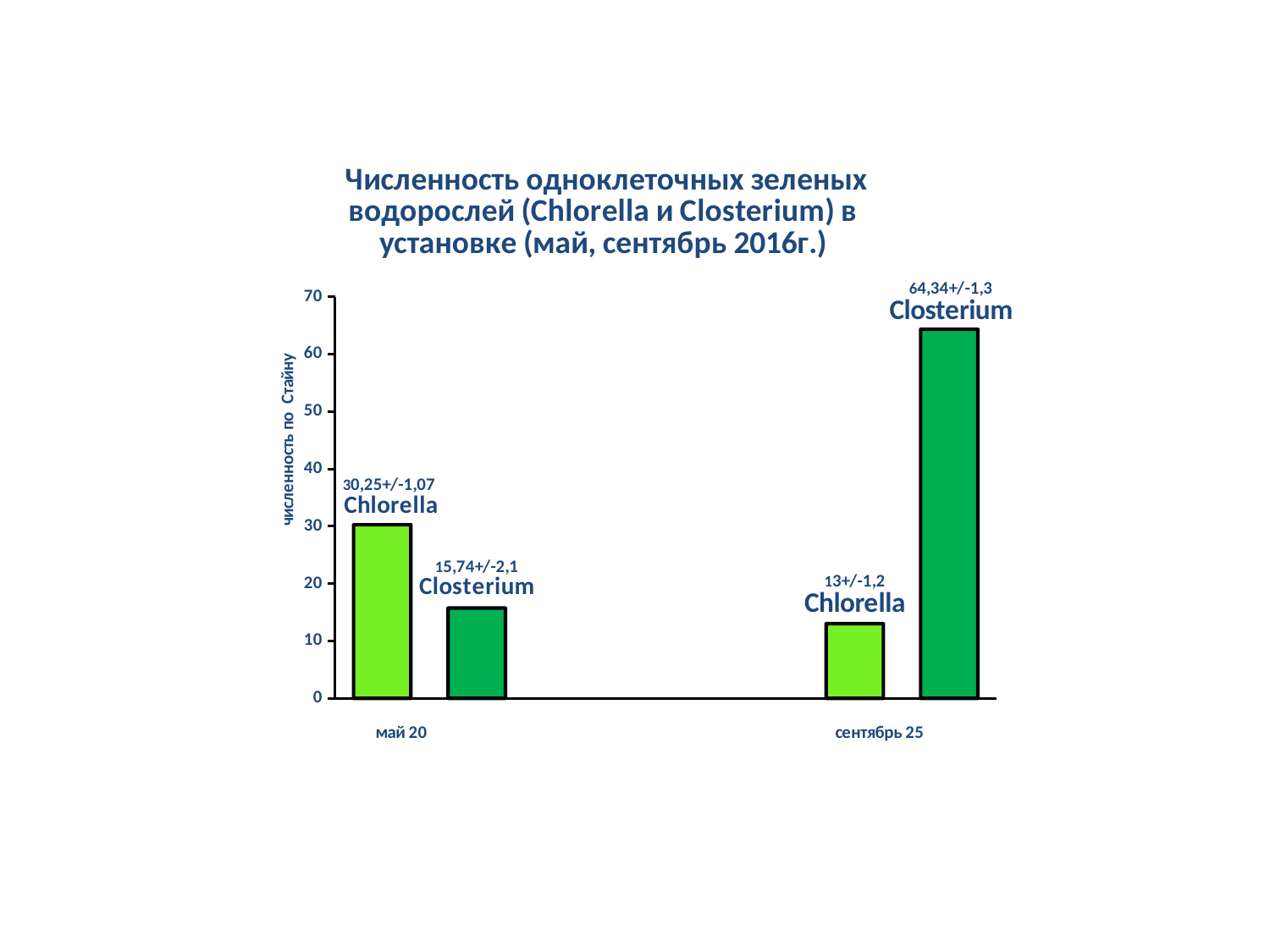
Which bar has the lowest value on the chart? Chlorella on сентябрь 25 Does the value for Chlorella rise or fall from май 20 to сентябрь 25? fall Which bar has the highest value on the chart? Closterium on сентябрь 25 What is the value for Closterium on май 20? 15,74+/-2,1 What is the title of the vertical axis? численность по Стайну Is the value for Closterium on сентябрь 25 greater or less than 60? greater What is the value for Chlorella on май 20? 30,25+/-1,07 What kind of chart is shown on the slide? bar chart What is the value for Closterium on сентябрь 25? 64,34+/-1,3 What is the value for Chlorella on сентябрь 25? 13+/-1,2 Which is larger on май 20, Chlorella or Closterium? Chlorella How many date categories are shown on the x axis? 2